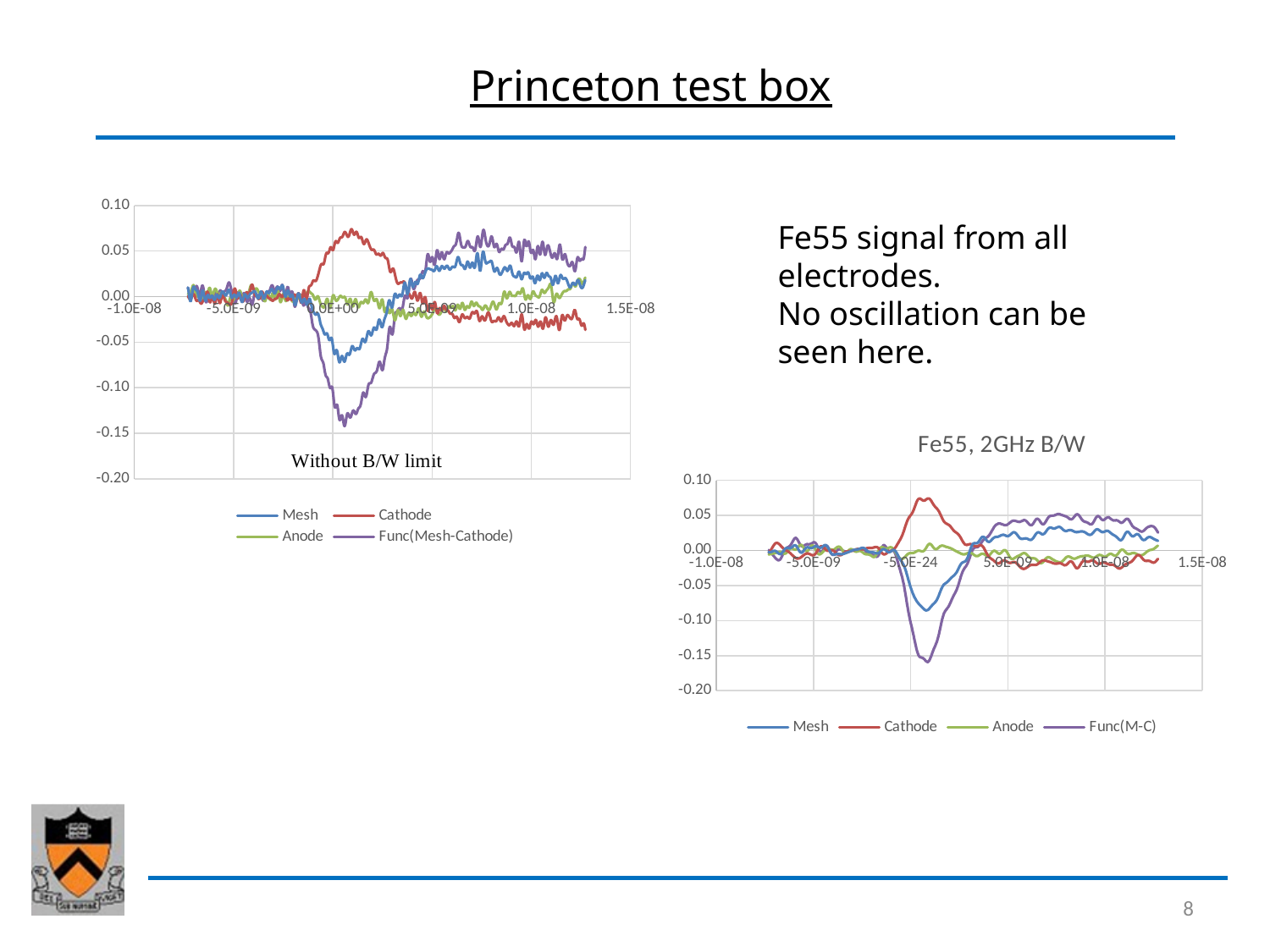
How many series does the legend of the 'Fe55, 2GHz B/W' chart list? 4 In the left chart ('Without B/W limit'), what is the name of the series drawn in purple? Func(Mesh-Cathode) In the left chart ('Without B/W limit'), is the peak value of the Cathode series greater or less than 0.05? greater In the left chart ('Without B/W limit'), is the lowest value reached by the Func(Mesh-Cathode) series greater or less than -0.10? less In the 'Fe55, 2GHz B/W' chart, what is the name of the fourth series in the legend? Func(M-C) What type of chart is the 'Fe55, 2GHz B/W' chart on the right? line chart In the 'Fe55, 2GHz B/W' chart, is the lowest value reached by the Func(M-C) series greater or less than -0.10? less In the 'Fe55, 2GHz B/W' chart, which series reaches a higher positive peak, Cathode or Func(M-C)? Cathode In the 'Fe55, 2GHz B/W' chart, which series reaches the lowest value on the y axis? Func(M-C) How many series does the legend of the left chart ('Without B/W limit') list? 4